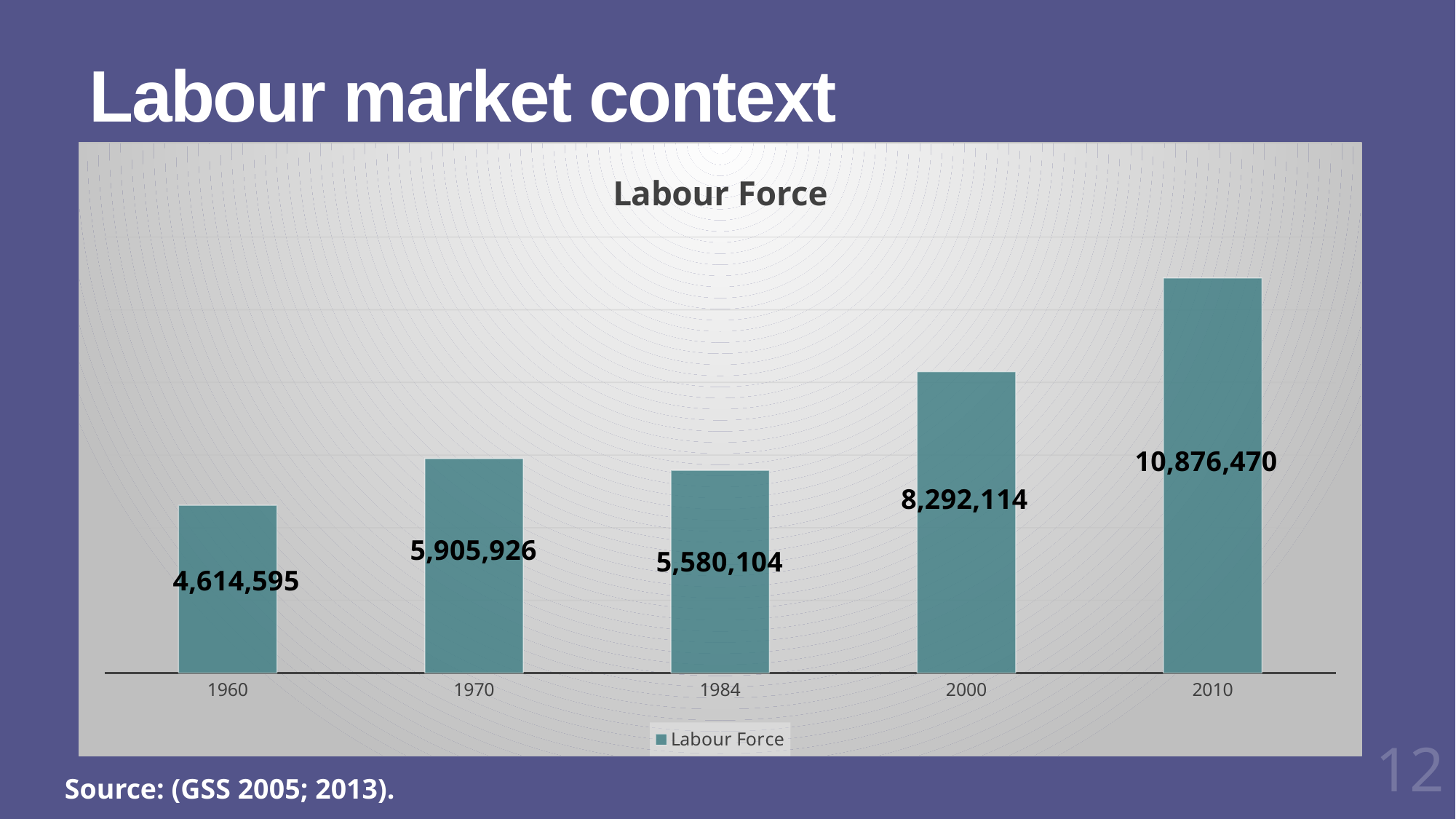
What kind of chart is shown on the slide? Bar chart What is the labour force value for 1984? 5,580,104 What is the labour force value for 1960? 4,614,595 What is the labour force value for 2010? 10,876,470 How many years are shown on the x axis? 5 Which is larger, the labour force in 1970 or in 1984? 1970 How many series does the legend list? 1 What is the difference between the labour force in 1970 and in 1984? 325,822 What is the title of the chart? Labour Force What is the difference between the labour force in 2010 and in 2000? 2,584,356 Which year has the highest labour force? 2010 Which year has the lowest labour force? 1960